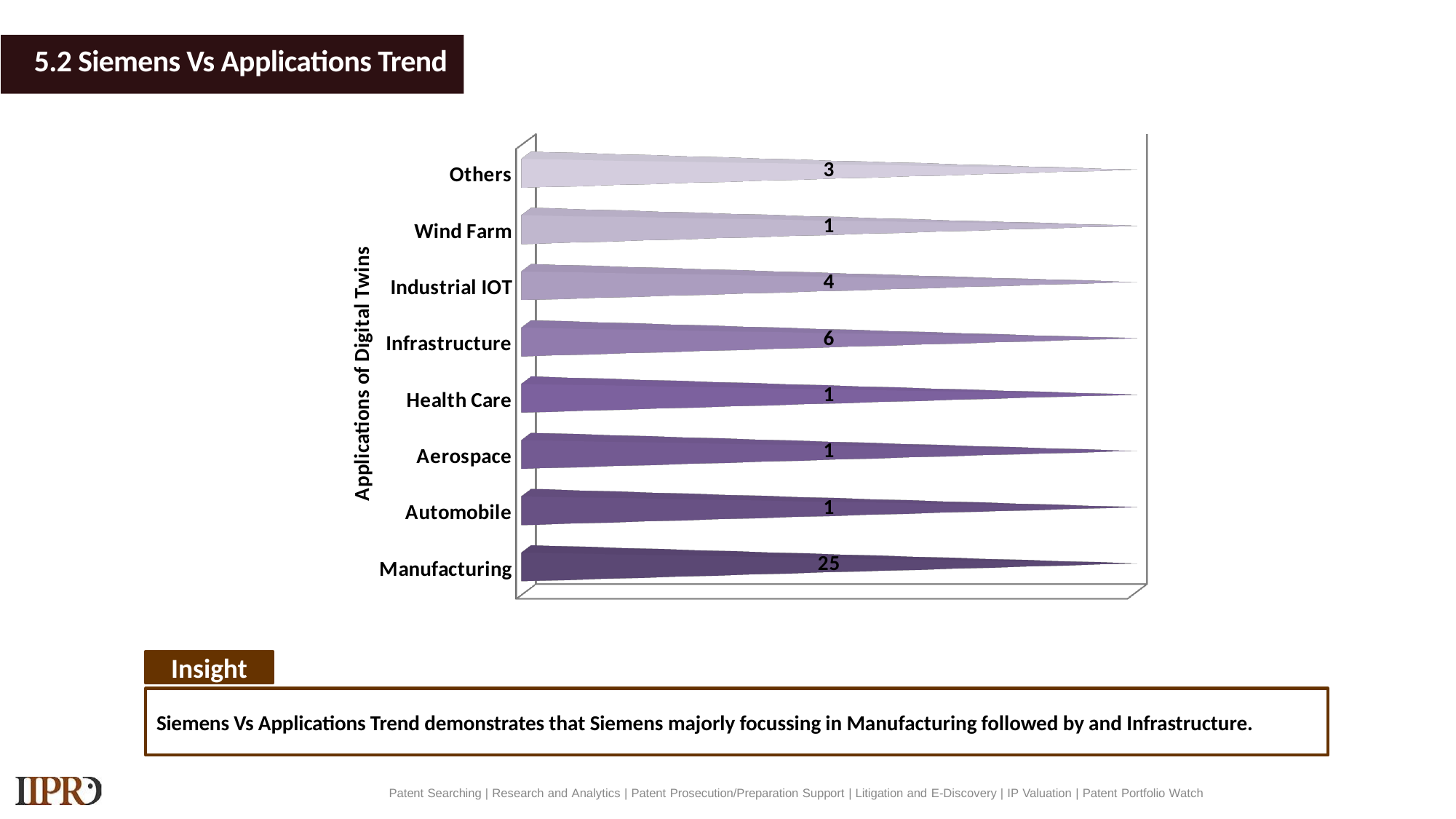
Which application has the highest value? Manufacturing What is the value for Infrastructure? 6 How many application categories are shown in the chart? 8 What is the difference between the values for Industrial IOT and Others? 1 What is the value for Health Care? 1 What is the value for Manufacturing? 25 Which has a larger value, Infrastructure or Industrial IOT? Infrastructure What is the title of the vertical axis of the chart? Applications of Digital Twins What is the value for Others? 3 What is the value for Industrial IOT? 4 What kind of chart is shown on the slide? Bar chart What is the difference between the values for Manufacturing and Infrastructure? 19